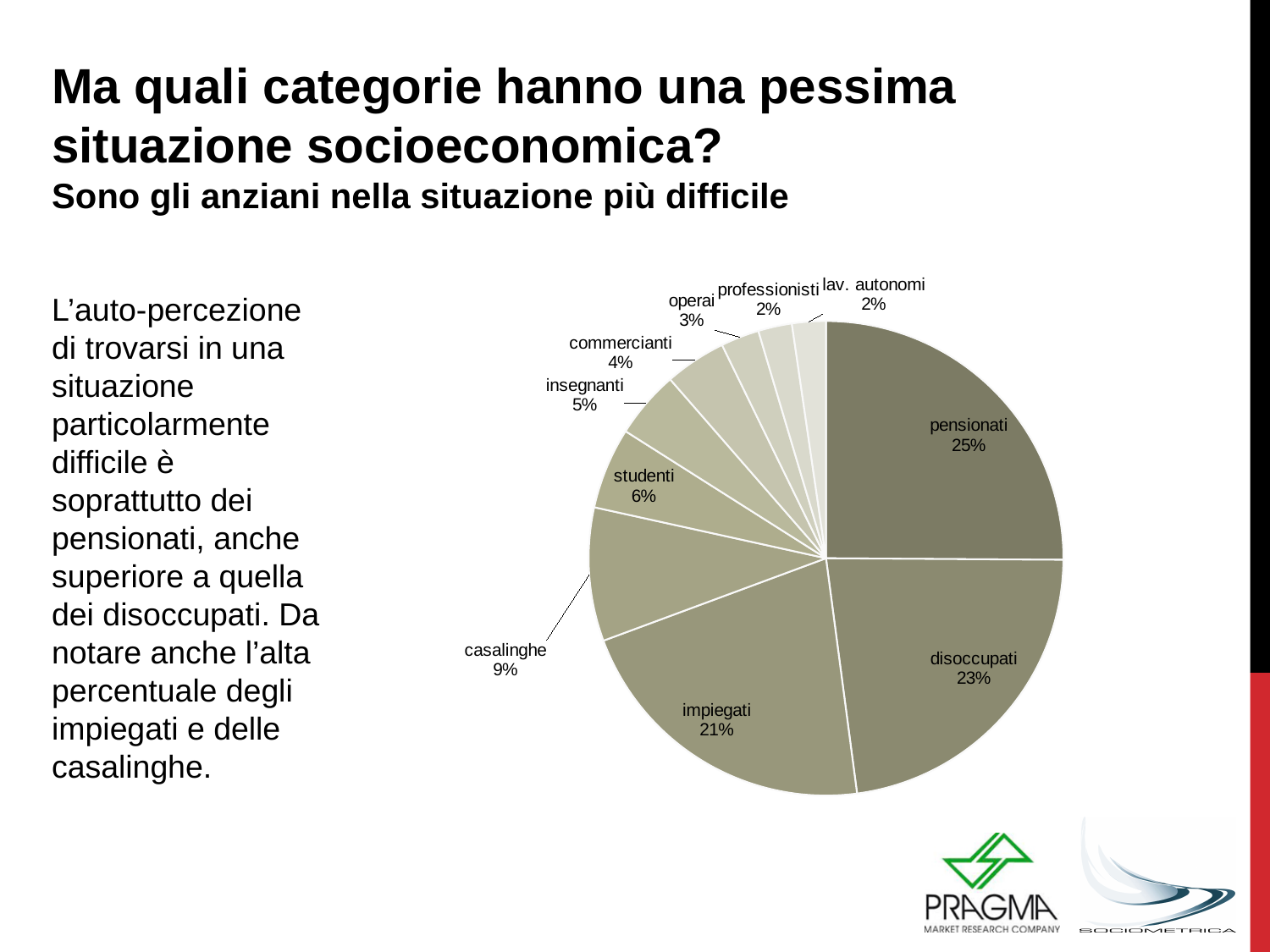
Which category has the largest slice of the pie? pensionati What is the difference in percentage points between pensionati and disoccupati? 2 What percentage is shown for insegnanti? 5% Which two categories share the smallest value of 2%? professionisti and lav. autonomi What percentage is shown for impiegati? 21% What kind of chart is shown on the slide? pie chart What percentage is shown for disoccupati? 23% How many categories are shown in the pie chart? 10 What percentage of the pie is labelled for pensionati? 25% What percentage is shown for casalinghe? 9% What is the difference in percentage points between impiegati and casalinghe? 12 Which category has the smallest share, studenti or operai? operai